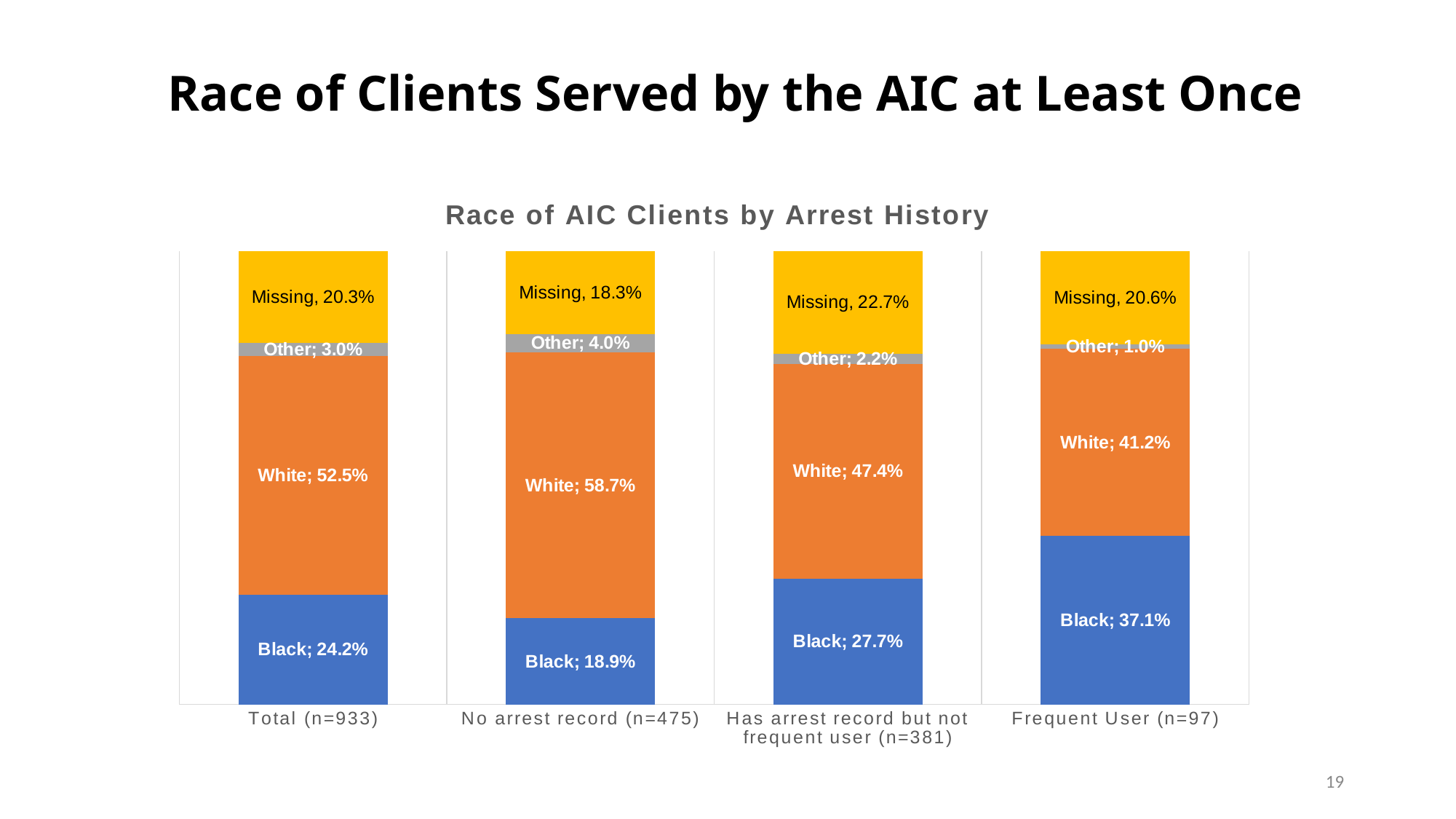
What is the Missing share for the Has arrest record but not frequent user (n=381) group? 22.7% What percentage of clients in the Total (n=933) group are Black? 24.2% What is the total of the four segments in the Total (n=933) bar? 100.0% What is the chart type? Stacked bar chart What is the difference between the White share for No arrest record (n=475) and for Frequent User (n=97)? 17.5 percentage points Which group has the lowest White share? Frequent User (n=97) How many categories are shown along the x axis? 4 Which is larger: the Missing share for Total (n=933) or for No arrest record (n=475)? Total (n=933) What is the Other share for the Frequent User (n=97) group? 1.0% What is the White share for the No arrest record (n=475) group? 58.7% Which group has the highest Black share? Frequent User (n=97) What is the title of the chart? Race of AIC Clients by Arrest History